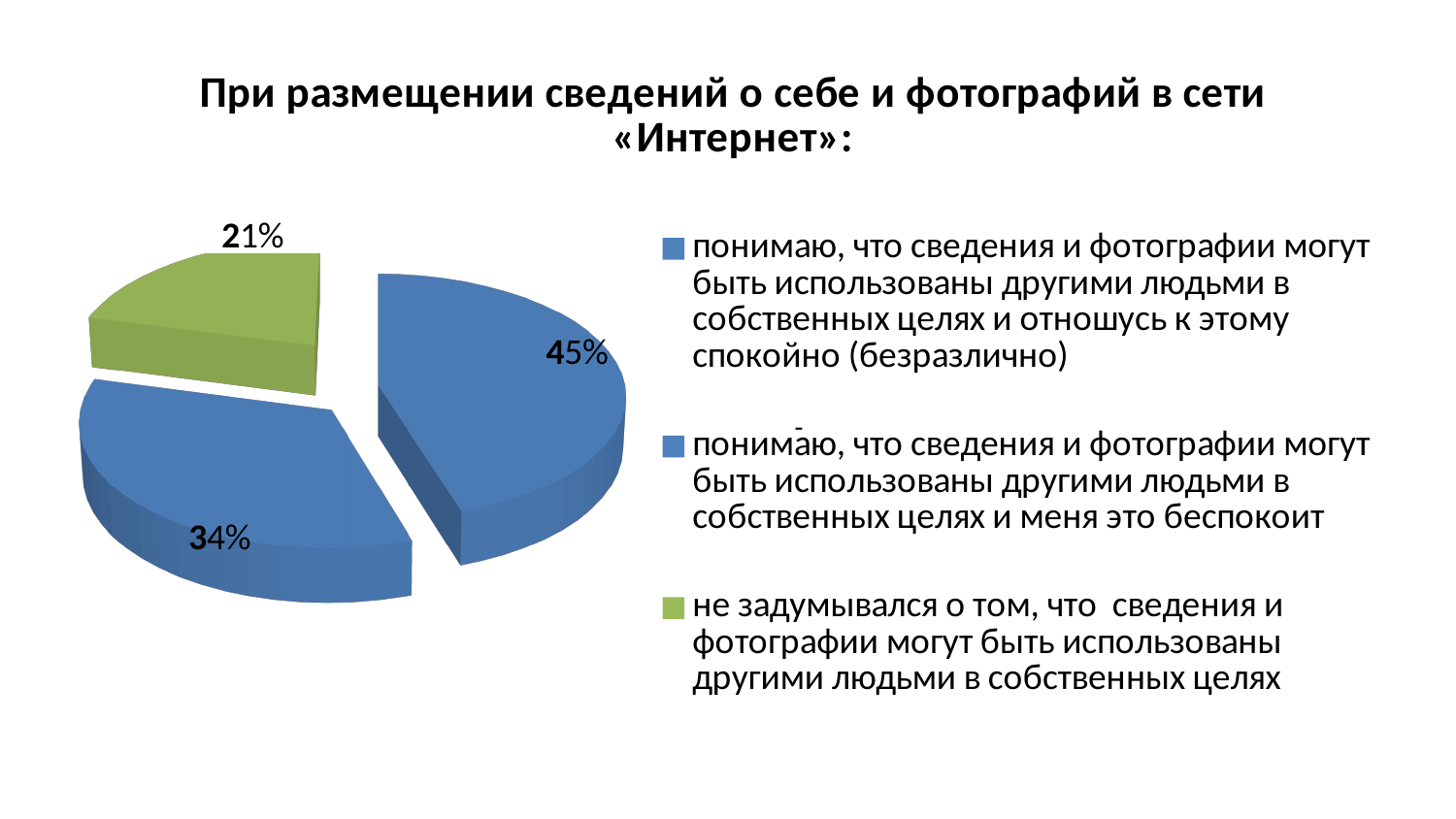
Which is larger: the slice labelled 34% or the slice labelled 21%? 34% What kind of chart is shown on the slide? Pie chart What is the value of the smallest slice in the pie chart? 21% What do the three slice percentages (45%, 34%, 21%) add up to? 100% What is the difference between the largest slice (45%) and the 34% slice? 11% What colour is the slice for «не задумывался о том, что сведения и фотографии могут быть использованы другими людьми в собственных целях»? Green What is the difference between the 45% slice and the 21% slice? 24% How many slices does the pie chart have? 3 What share of the pie is labelled for the green slice, «не задумывался о том, что сведения и фотографии могут быть использованы другими людьми в собственных целях»? 21% What is the value of the largest slice in the pie chart? 45% How many entries does the legend list? 3 What is the title of the slide above the chart? При размещении сведений о себе и фотографий в сети «Интернет»: